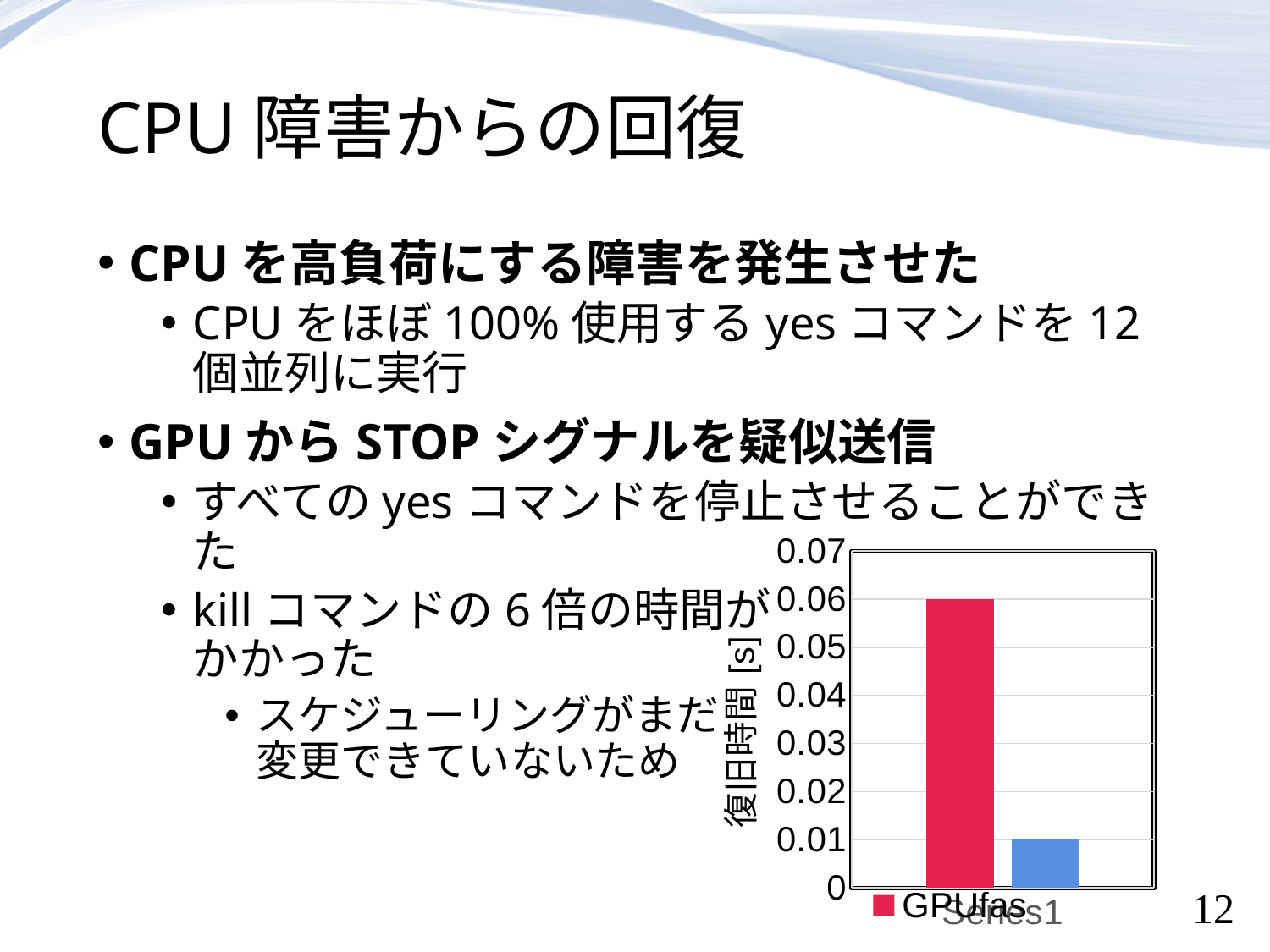
What value does the blue bar reach on the y axis? 0.01 What value does the red bar reach on the y axis? 0.06 Is the value of the blue bar greater or less than 0.02? less What is the highest tick value shown on the y axis? 0.07 Which bar is the tallest in the chart? the red bar Which is larger, the red bar or the blue bar? the red bar Is the value of the red bar greater or less than 0.05? greater What kind of chart is shown on the slide? bar chart Which bar is the shortest in the chart? the blue bar What is the label of the y axis of the chart? 復旧時間 [s] What is the difference between the red bar and the blue bar? 0.05 How many bars are plotted in the chart? 2